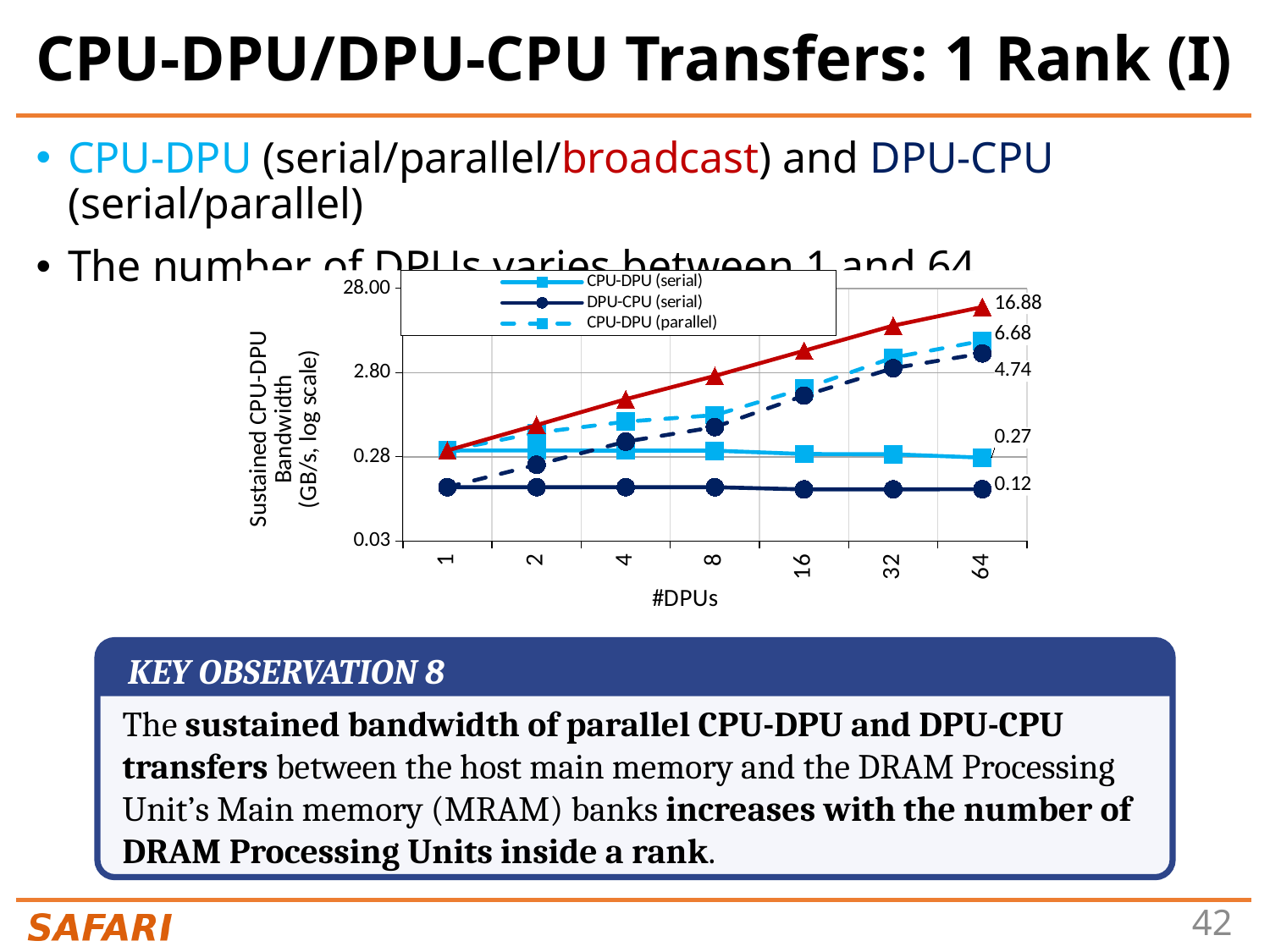
At 64 DPUs, what is the difference between the CPU-DPU (parallel) value and the CPU-DPU (serial) value? 6.41 Is the value for CPU-DPU (parallel) at 16 DPUs greater or less than 0.28? greater What is the sustained bandwidth for CPU-DPU (parallel) at 64 DPUs? 6.68 Does the CPU-DPU (parallel) line rise or fall as the number of DPUs increases? rises What kind of chart is shown on the slide? line chart Is the value for DPU-CPU (serial) at 1 DPU greater or less than 0.28? less What is the sustained bandwidth for DPU-CPU (serial) at 64 DPUs? 0.12 What is the label of the x axis of the chart? #DPUs What is the sustained bandwidth for CPU-DPU (serial) at 64 DPUs? 0.27 At 64 DPUs, what is the difference between the CPU-DPU (serial) value and the DPU-CPU (serial) value? 0.15 How many #DPUs values are shown on the x axis of the chart? 7 At 64 DPUs, which is larger: CPU-DPU (serial) or DPU-CPU (serial)? CPU-DPU (serial)